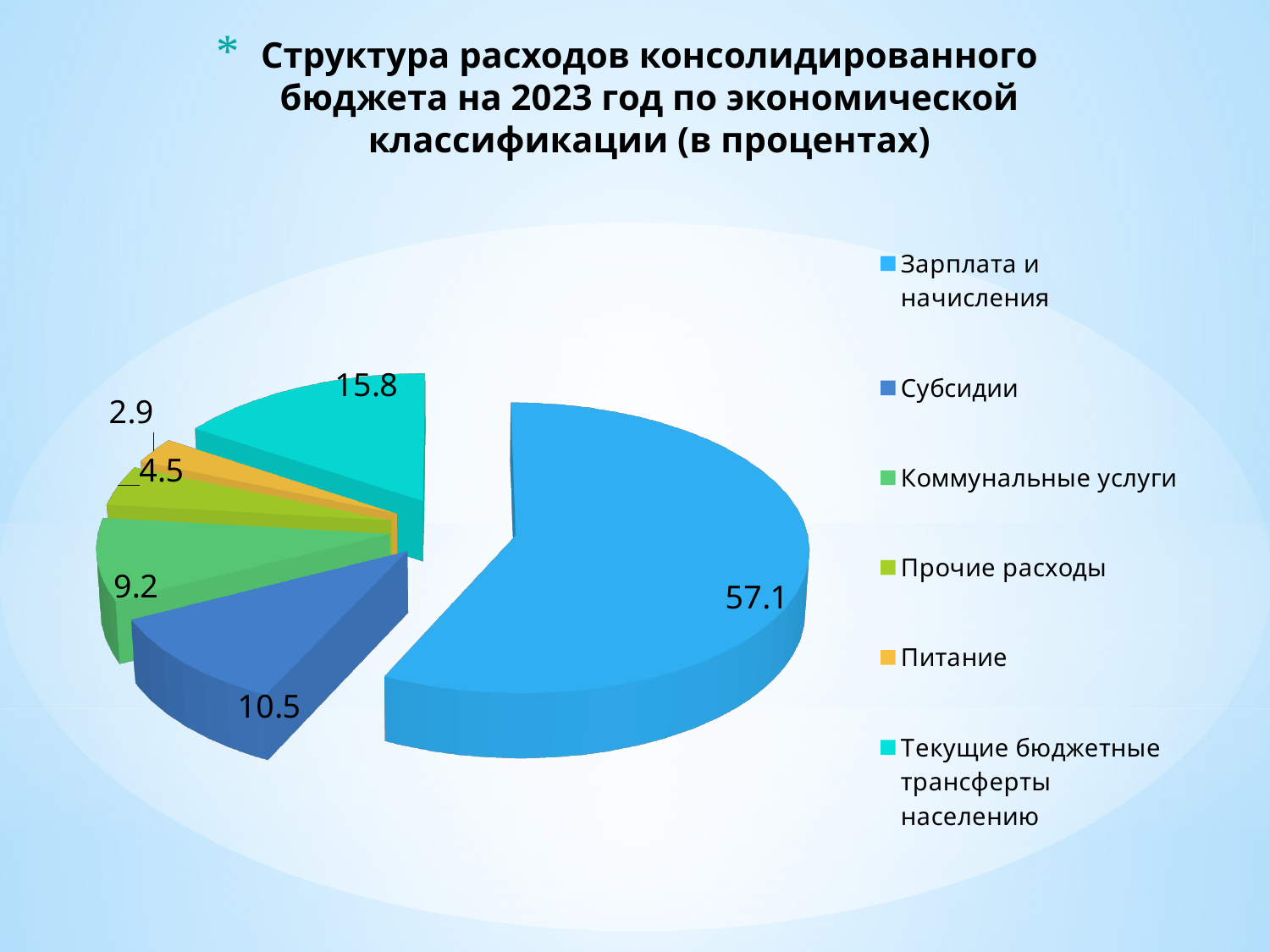
Какой тип диаграммы показан на слайде? Круговая диаграмма Какое значение у категории «Текущие бюджетные трансферты населению»? 15.8 Какое значение у категории «Субсидии»? 10.5 Каким цветом обозначена категория «Питание» в легенде? Оранжевым (жёлтым) Какая категория имеет наименьшую долю? Питание Сколько категорий показано на диаграмме? 6 На сколько значение «Текущие бюджетные трансферты населению» больше значения «Субсидии»? 5.3 Какое значение у категории «Питание»? 2.9 Какое значение у категории «Зарплата и начисления»? 57.1 Что больше: «Коммунальные услуги» или «Прочие расходы»? Коммунальные услуги Какое значение у категории «Коммунальные услуги»? 9.2 Какая категория имеет наибольшую долю? Зарплата и начисления